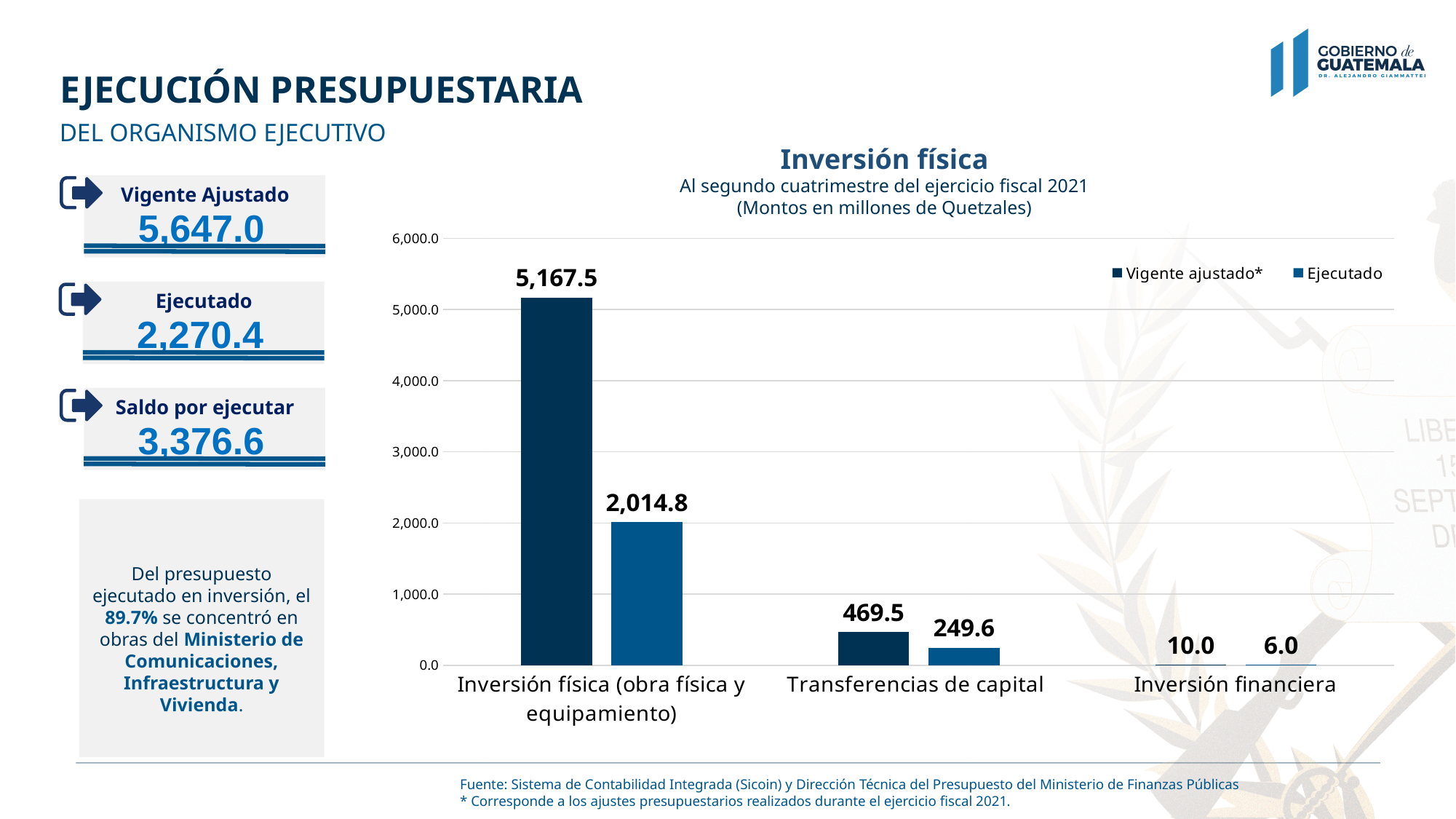
What is the Ejecutado value for Inversión financiera? 6.0 How many series does the chart legend list? 2 What kind of chart is shown on the slide? Bar chart What is the difference between the Vigente ajustado* and Ejecutado values for Inversión física (obra física y equipamiento)? 3,152.7 Which category has the highest Vigente ajustado* value? Inversión física (obra física y equipamiento) What is the difference between the Vigente ajustado* and Ejecutado values for Transferencias de capital? 219.9 What is the Ejecutado value for Transferencias de capital? 249.6 Which is larger: the Ejecutado value for Inversión física (obra física y equipamiento) or the Vigente ajustado* value for Transferencias de capital? Ejecutado value for Inversión física (obra física y equipamiento) What is the title of the chart? Inversión física Which category has the lowest Ejecutado value? Inversión financiera What is the Vigente ajustado* value for Inversión física (obra física y equipamiento)? 5,167.5 How many categories are shown on the x axis of the chart? 3